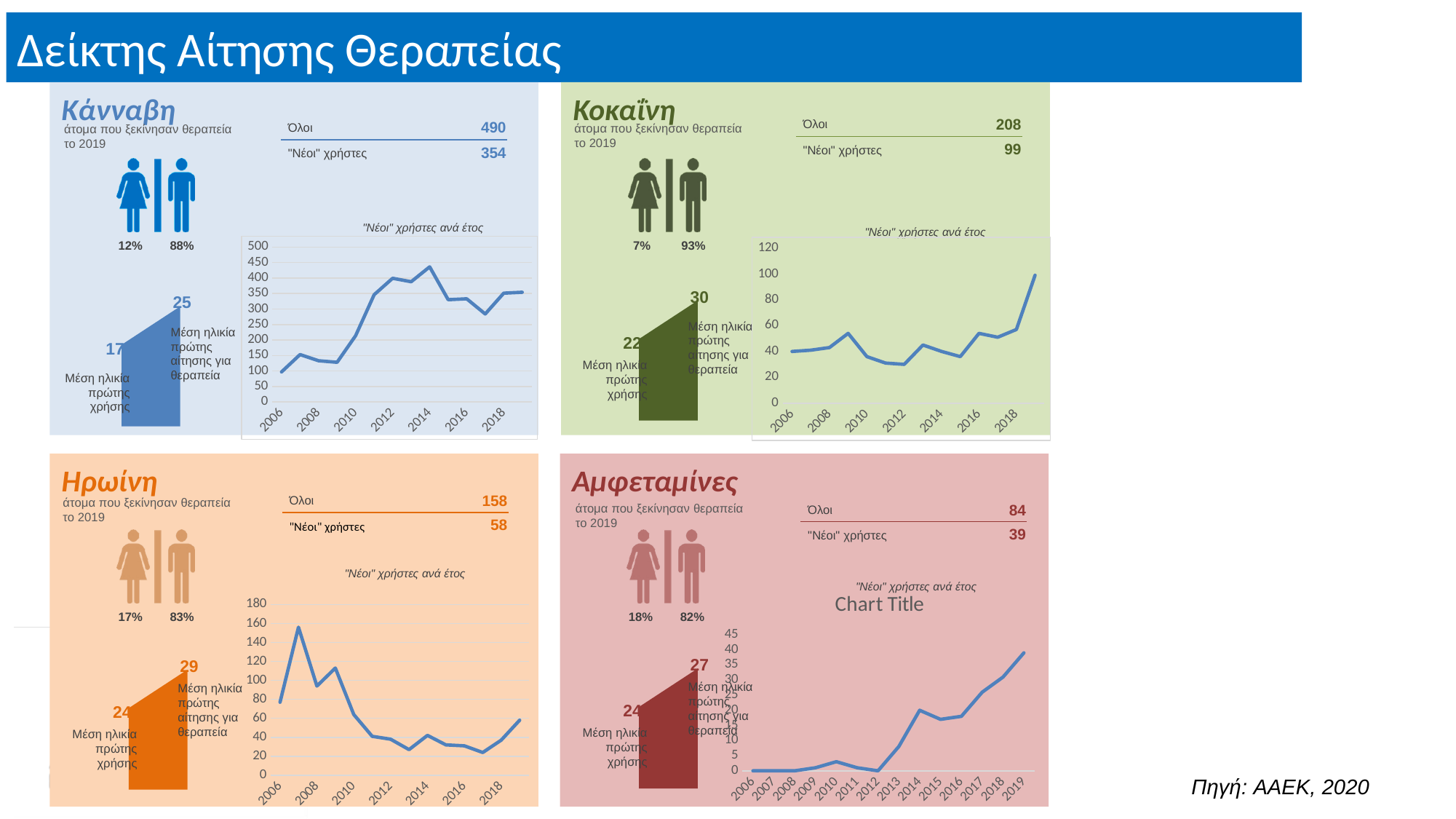
In the Ηρωίνη chart, is the value for 2007 greater or less than 140? greater In the Ηρωίνη chart, do the values overall rise or fall from 2006 to 2019? fall In the Αμφεταμίνες chart, how many years are labelled on the x axis? 14 What kind of chart is the "Νέοι χρήστες ανά έτος" chart in the Κάνναβη panel? line chart In the Ηρωίνη chart, which is larger, the value for 2007 or the value for 2019? 2007 In the Κοκαΐνη chart, which year has the highest value? 2019 In the Κάνναβη chart, which year has the lowest value? 2006 In the Κάνναβη chart, is the value for 2014 greater or less than 400? greater In the Κάνναβη chart, which year has the highest value? 2014 How many line charts are shown on the slide? 4 In the Αμφεταμίνες chart, is the value for 2012 greater or less than 5? less